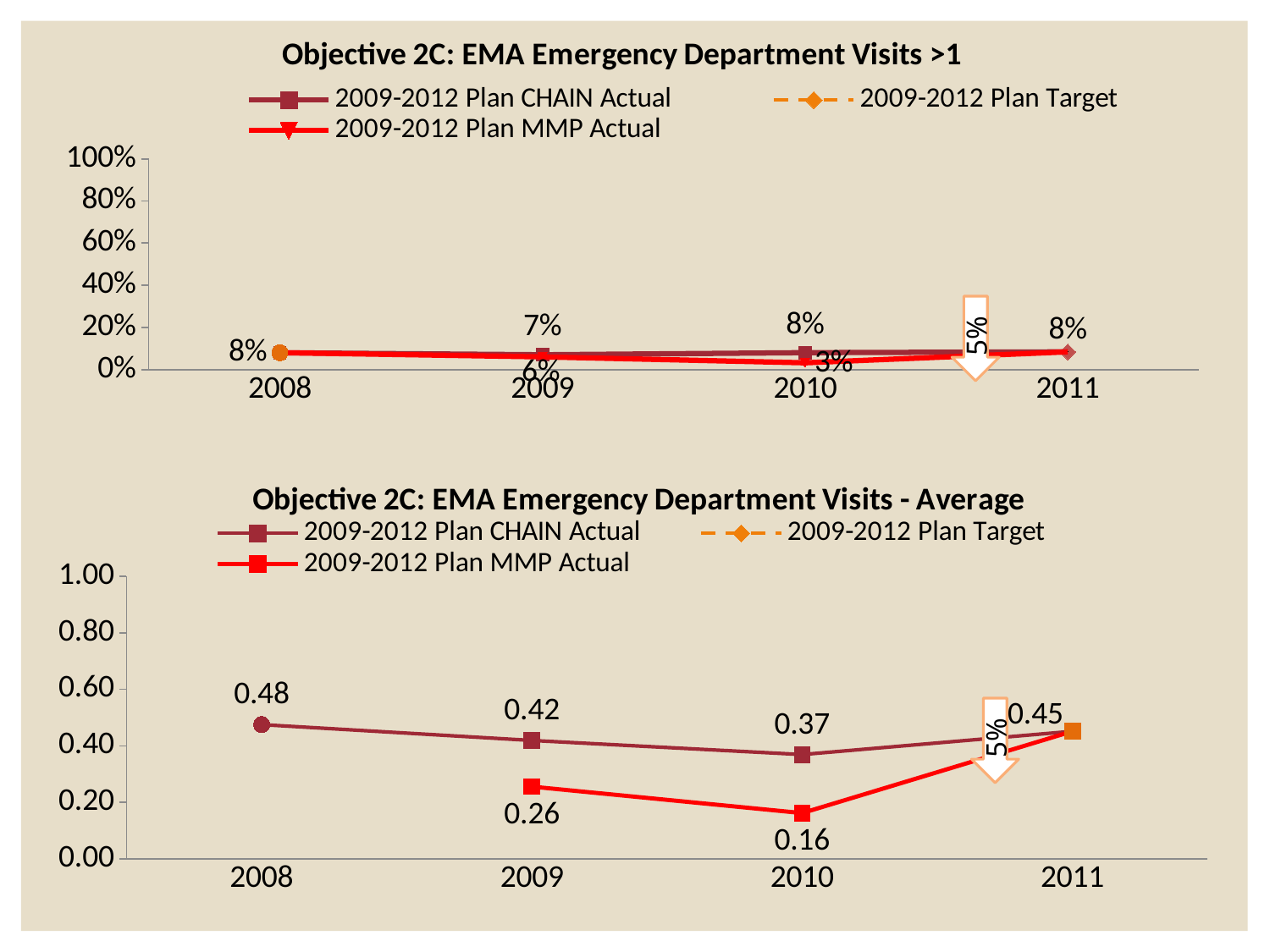
In the top chart, 'Objective 2C: EMA Emergency Department Visits >1', is the 2009-2012 Plan CHAIN Actual value for 2010 greater or less than 20%? less In the top chart, 'Objective 2C: EMA Emergency Department Visits >1', what is the 2009-2012 Plan MMP Actual value for 2010? 3% In the bottom chart, 'Objective 2C: EMA Emergency Department Visits - Average', does the 2009-2012 Plan CHAIN Actual line rise or fall from 2008 to 2010? fall In the bottom chart, 'Objective 2C: EMA Emergency Department Visits - Average', in which year is the 2009-2012 Plan CHAIN Actual value lowest? 2010 How many years are shown on the x axis of the bottom chart, 'Objective 2C: EMA Emergency Department Visits - Average'? 4 In the bottom chart, 'Objective 2C: EMA Emergency Department Visits - Average', which series has the larger value in 2009, 2009-2012 Plan CHAIN Actual or 2009-2012 Plan MMP Actual? 2009-2012 Plan CHAIN Actual In the bottom chart, 'Objective 2C: EMA Emergency Department Visits - Average', what is the difference between the 2009-2012 Plan CHAIN Actual values for 2008 and 2010? 0.11 What is the title of the top chart on the slide? Objective 2C: EMA Emergency Department Visits >1 In the bottom chart, 'Objective 2C: EMA Emergency Department Visits - Average', what is the 2009-2012 Plan CHAIN Actual value for 2008? 0.48 What kind of chart is the top chart, 'Objective 2C: EMA Emergency Department Visits >1'? line chart How many series does the legend of the bottom chart, 'Objective 2C: EMA Emergency Department Visits - Average', list? 3 In the bottom chart, 'Objective 2C: EMA Emergency Department Visits - Average', what is the 2009-2012 Plan MMP Actual value for 2010? 0.16